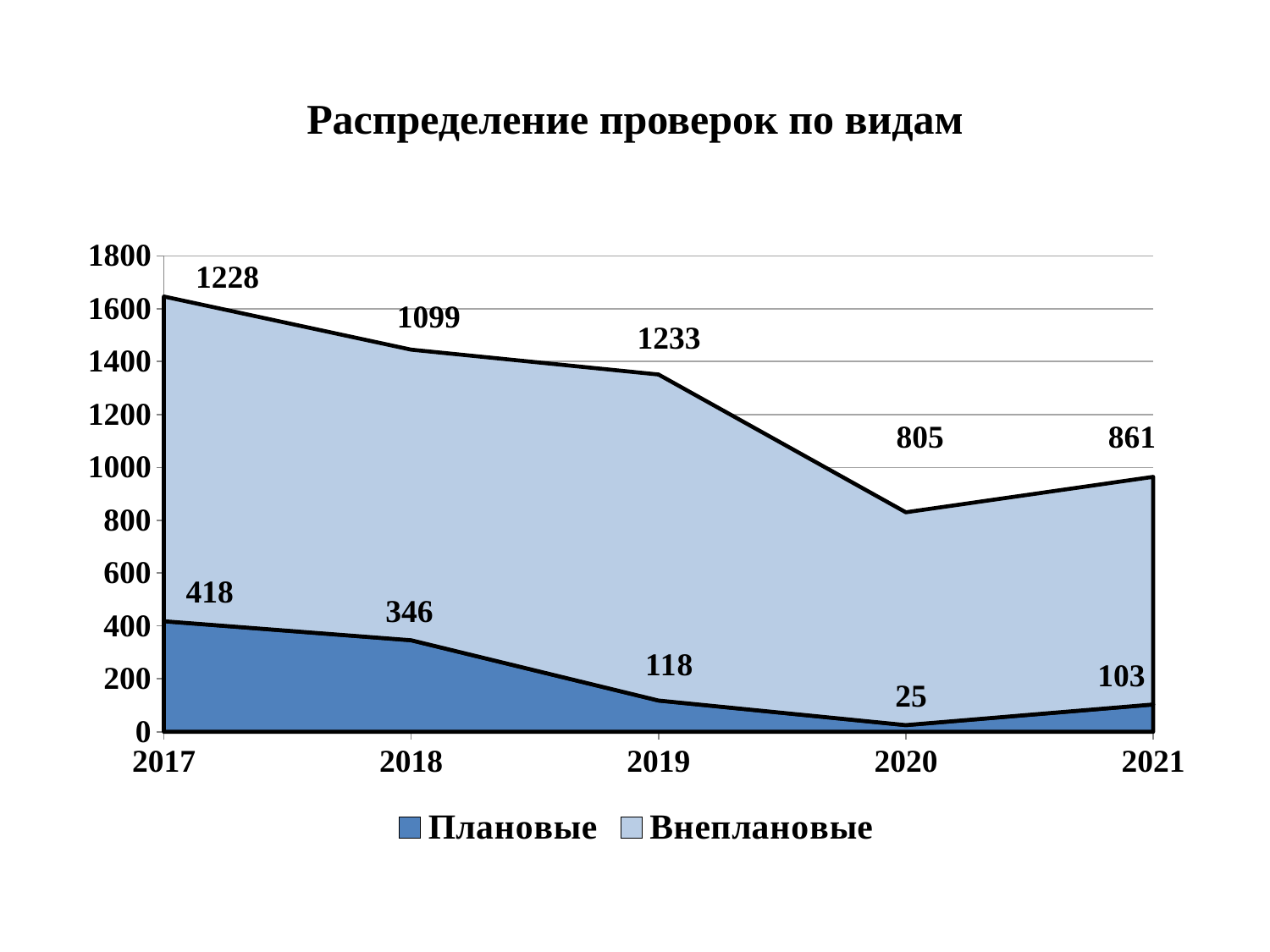
How many series does the legend list? 2 Which is larger: the Плановые value in 2018 or in 2021? 2018 In which year is the Внеплановые value lowest? 2020 What is the value for Внеплановые in 2019? 1233 What is the total of Плановые and Внеплановые in 2020? 830 What is the value for Плановые in 2020? 25 What is the difference between the Внеплановые values for 2019 and 2020? 428 What is the value for Плановые in 2017? 418 What kind of chart is this? Stacked area chart How many years are shown on the x axis? 5 What is the title of the chart? Распределение проверок по видам In which year is the Плановые value highest? 2017